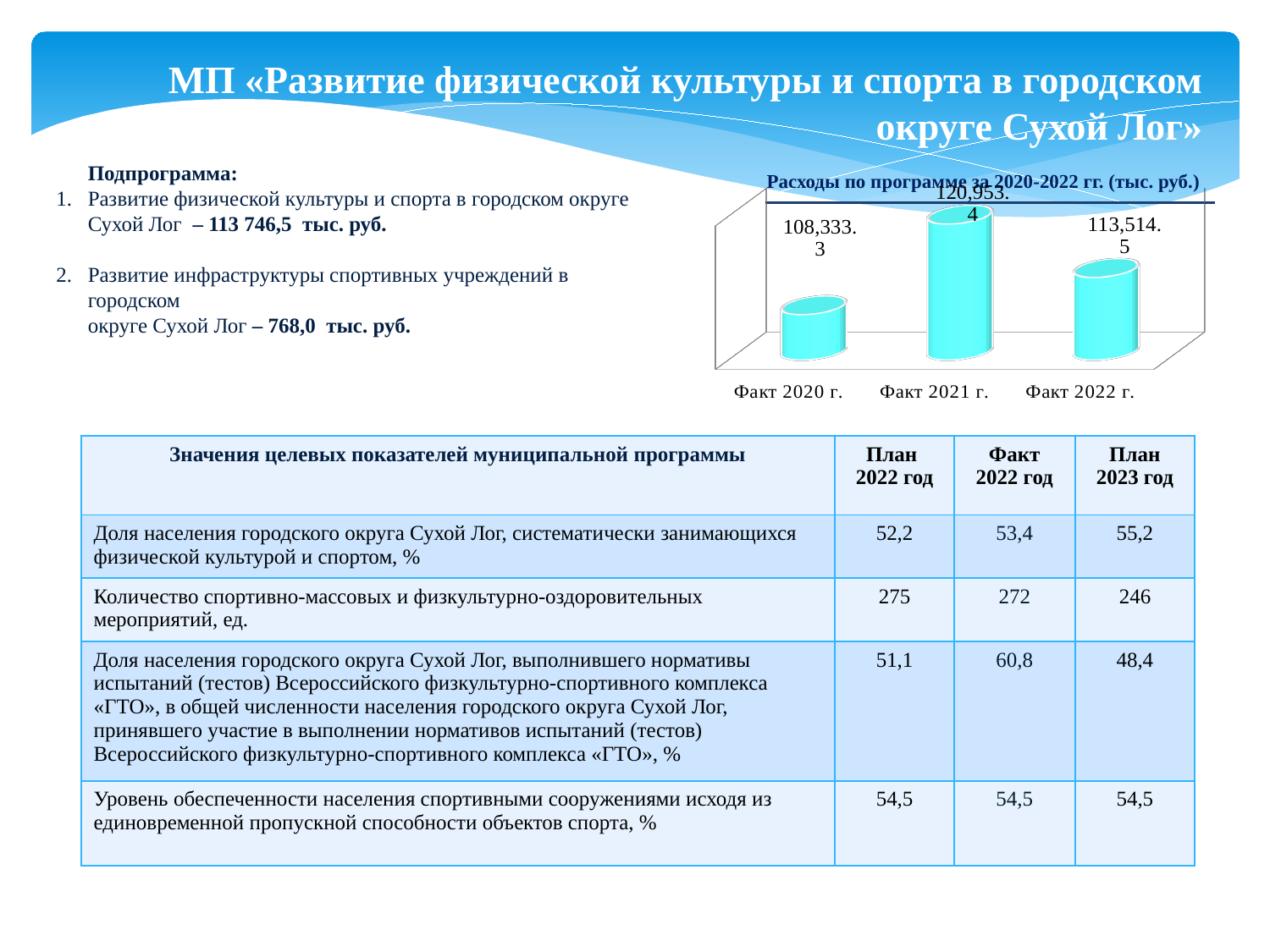
Which year has the lowest expenditure in the chart? Факт 2020 г. What is the value for Факт 2021 г. in the chart? 120,953.4 Do the values rise or fall from Факт 2021 г. to Факт 2022 г.? Fall What is the difference between the values for Факт 2021 г. and Факт 2022 г.? 7,438.9 What is the title of the chart? Расходы по программе за 2020-2022 гг. (тыс. руб.) Which is larger, the value for Факт 2022 г. or the value for Факт 2020 г.? Факт 2022 г. What is the value for Факт 2020 г. in the chart? 108,333.3 What is the value for Факт 2022 г. in the chart? 113,514.5 How many categories are shown in the chart? 3 What kind of chart is shown on the slide? Bar chart What is the difference between the values for Факт 2021 г. and Факт 2020 г.? 12,620.1 Which year has the highest expenditure in the chart? Факт 2021 г.